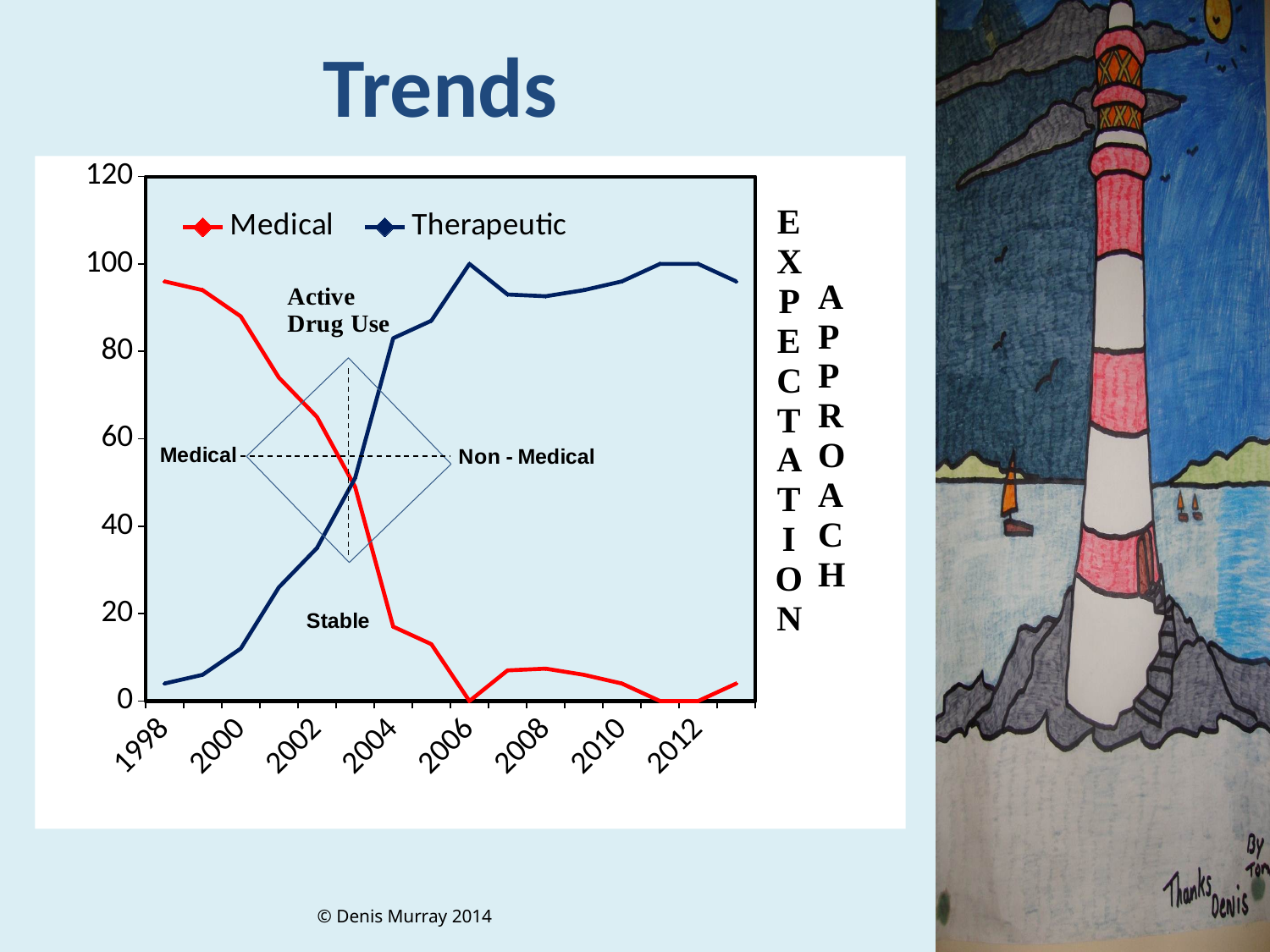
Is the value for Medical in 2004 greater or less than 40? less Does the Therapeutic series rise or fall from 1998 to 2012? rise In 1998, which series has the higher value, Medical or Therapeutic? Medical What kind of chart is shown on the slide? line chart Is the value for Therapeutic in 2010 greater or less than 80? greater What are the two series named in the chart's legend? Medical and Therapeutic Is the value for Medical in 1998 greater or less than 80? greater What is the title of the slide containing the chart? Trends In 2008, which series has the higher value, Medical or Therapeutic? Therapeutic Does the Medical series rise or fall from 1998 to 2012? fall How many series does the chart's legend list? 2